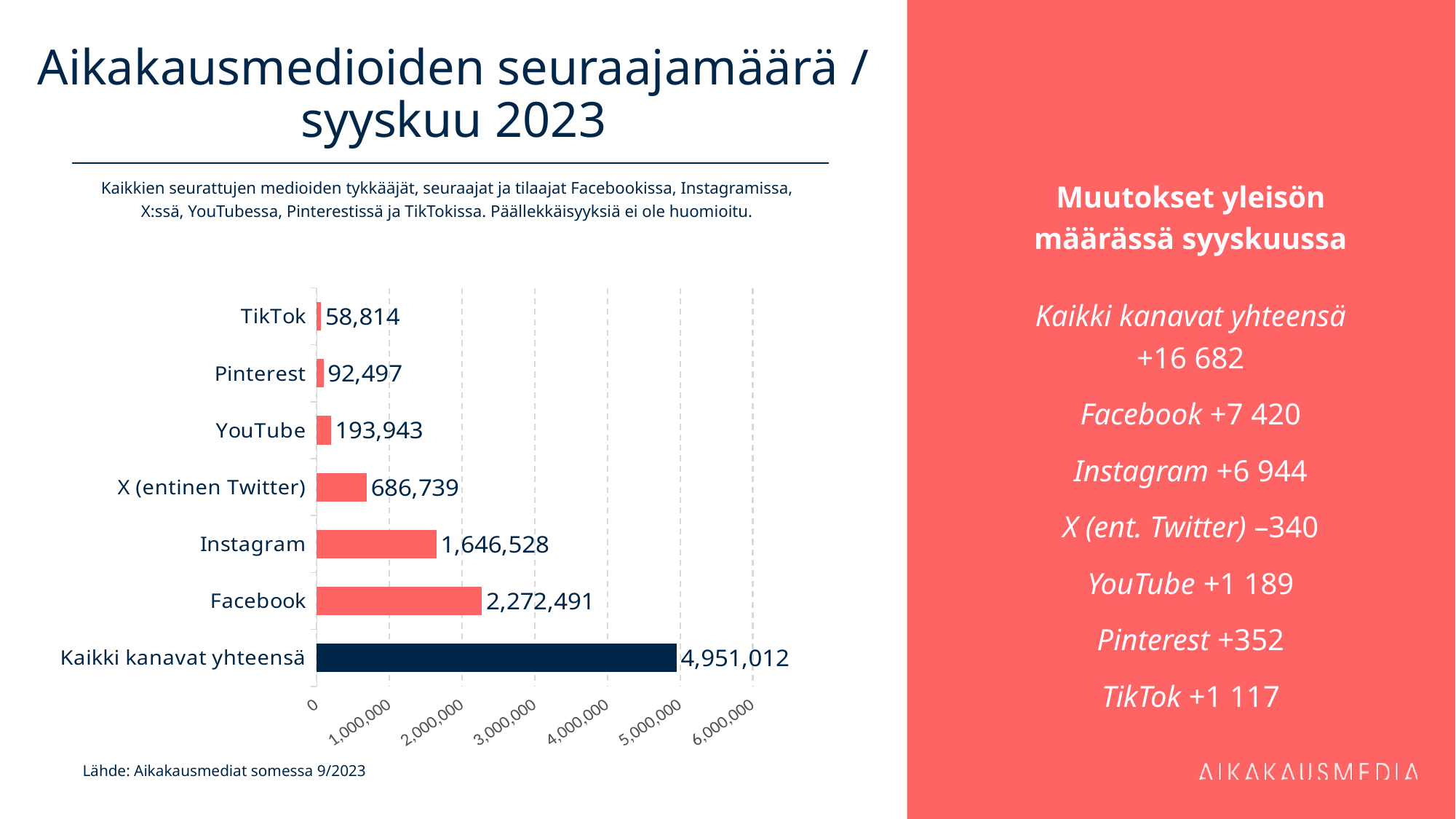
What is the value shown for X (entinen Twitter)? 686,739 What is the value shown for Instagram? 1,646,528 What kind of chart is shown on the slide? bar chart What is the value shown for Facebook? 2,272,491 Which category has the lowest value? TikTok What is the difference between the values for Pinterest and TikTok? 33,683 Which is larger, the value for YouTube or the value for Pinterest? YouTube How many categories are shown in the chart? 7 Which individual channel (excluding the total bar) has the highest value? Facebook Is the value for X (entinen Twitter) greater or less than 1,000,000? less What is the difference between the values for Facebook and Instagram? 625,963 What is the value shown for Kaikki kanavat yhteensä? 4,951,012